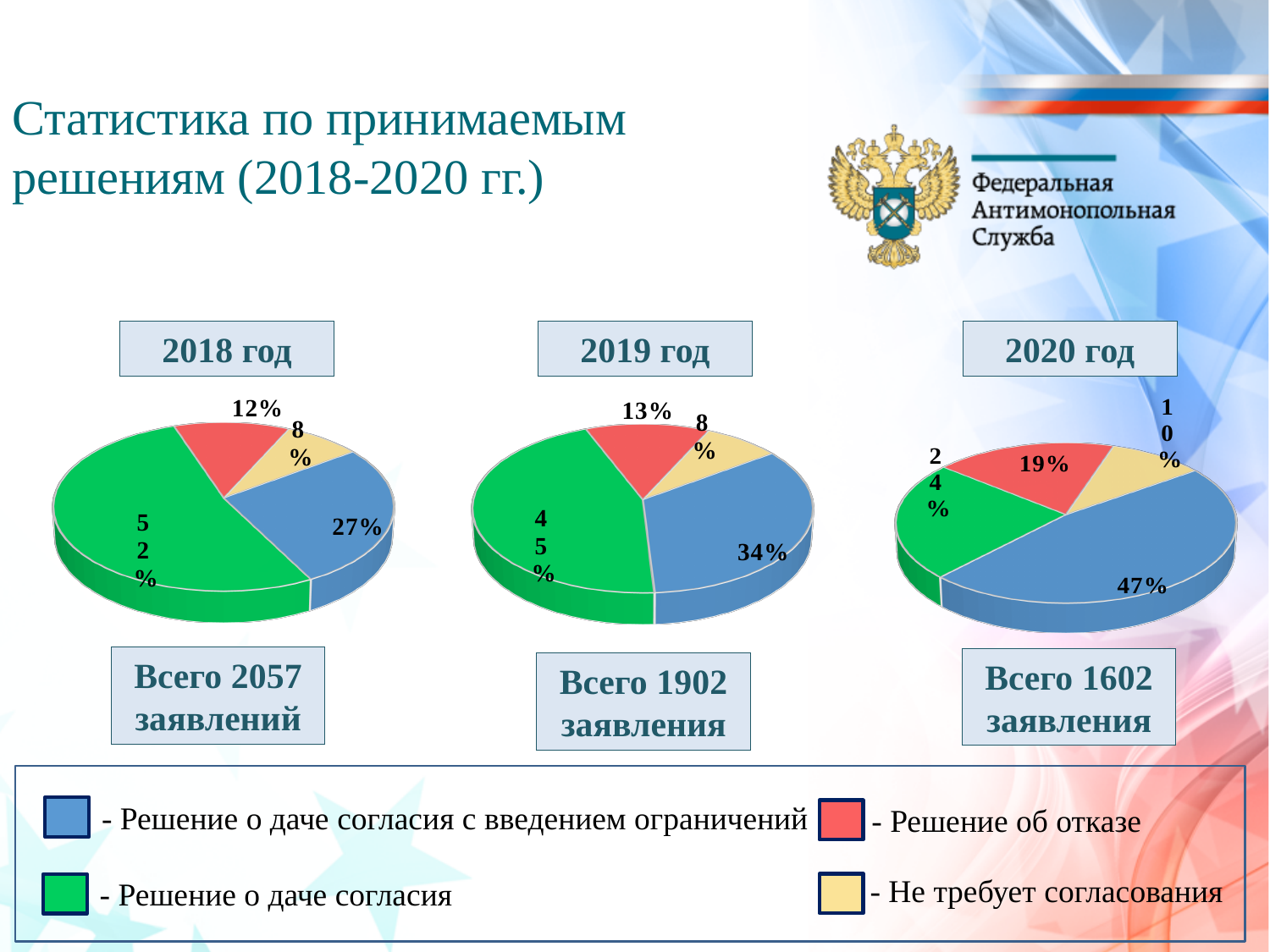
In the 2018 год pie chart, what share is shown for the blue slice (Решение о даче согласия с введением ограничений)? 27% How many slices does each pie chart on the slide have? 4 What kind of charts are shown on the slide? Pie charts In the 2020 год pie chart, which category has the smallest share? Не требует согласования According to the slide, what is the total number of applications (Всего заявлений) for 2019 год? 1902 In the 2018 год pie chart, what is the difference in percentage points between the green slice (52%) and the blue slice (27%)? 25 In the 2019 год pie chart, which category has the largest share? Решение о даче согласия In the 2020 год pie chart, what share is shown for the yellow slice (Не требует согласования)? 10% In the 2018 год pie chart, what share is shown for the green slice (Решение о даче согласия)? 52% In the 2020 год pie chart, what share is shown for the blue slice (Решение о даче согласия с введением ограничений)? 47% In the 2019 год pie chart, what share is shown for the red slice (Решение об отказе)? 13% Which is larger in the 2020 год pie chart: the share for Решение об отказе or the share for Решение о даче согласия? Решение о даче согласия